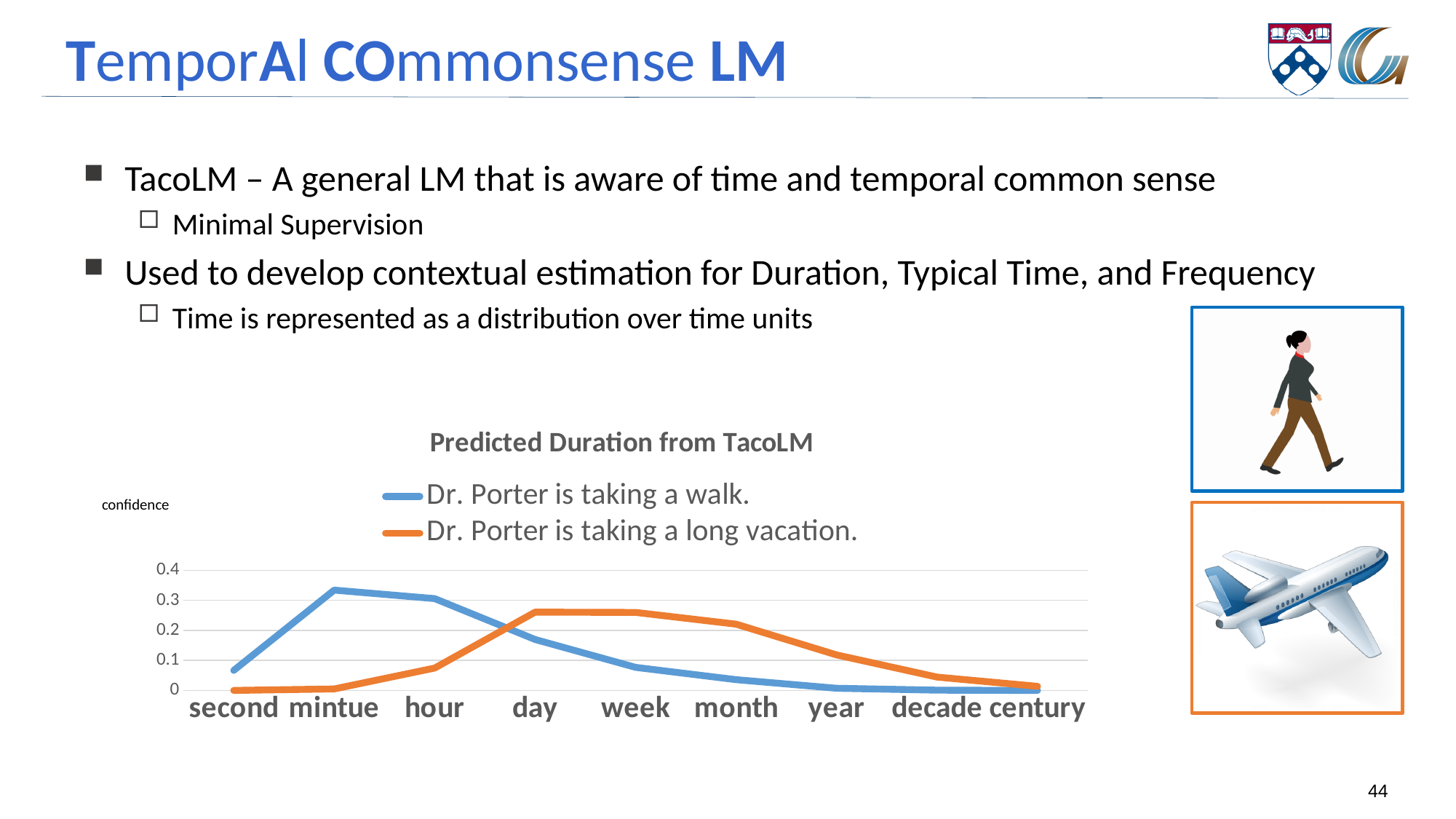
Is the value for 'Dr. Porter is taking a walk.' at 'week' greater or less than 0.1? less From 'week' to 'century', does the 'Dr. Porter is taking a long vacation.' series rise or fall? fall Is the value for 'Dr. Porter is taking a walk.' at 'mintue' greater or less than 0.3? greater What kind of chart is shown on the slide? line chart At 'month', which series has the larger value: 'Dr. Porter is taking a walk.' or 'Dr. Porter is taking a long vacation.'? Dr. Porter is taking a long vacation. How many series does the chart's legend list? 2 How many time-unit categories are shown on the x axis of the chart? 9 Which series is drawn in orange in the chart? Dr. Porter is taking a long vacation. For which time unit does the 'Dr. Porter is taking a walk.' series reach its highest value? mintue At 'mintue', which series has the larger value: 'Dr. Porter is taking a walk.' or 'Dr. Porter is taking a long vacation.'? Dr. Porter is taking a walk. What is the title of the chart? Predicted Duration from TacoLM Is the value for 'Dr. Porter is taking a long vacation.' at 'second' greater or less than 0.1? less